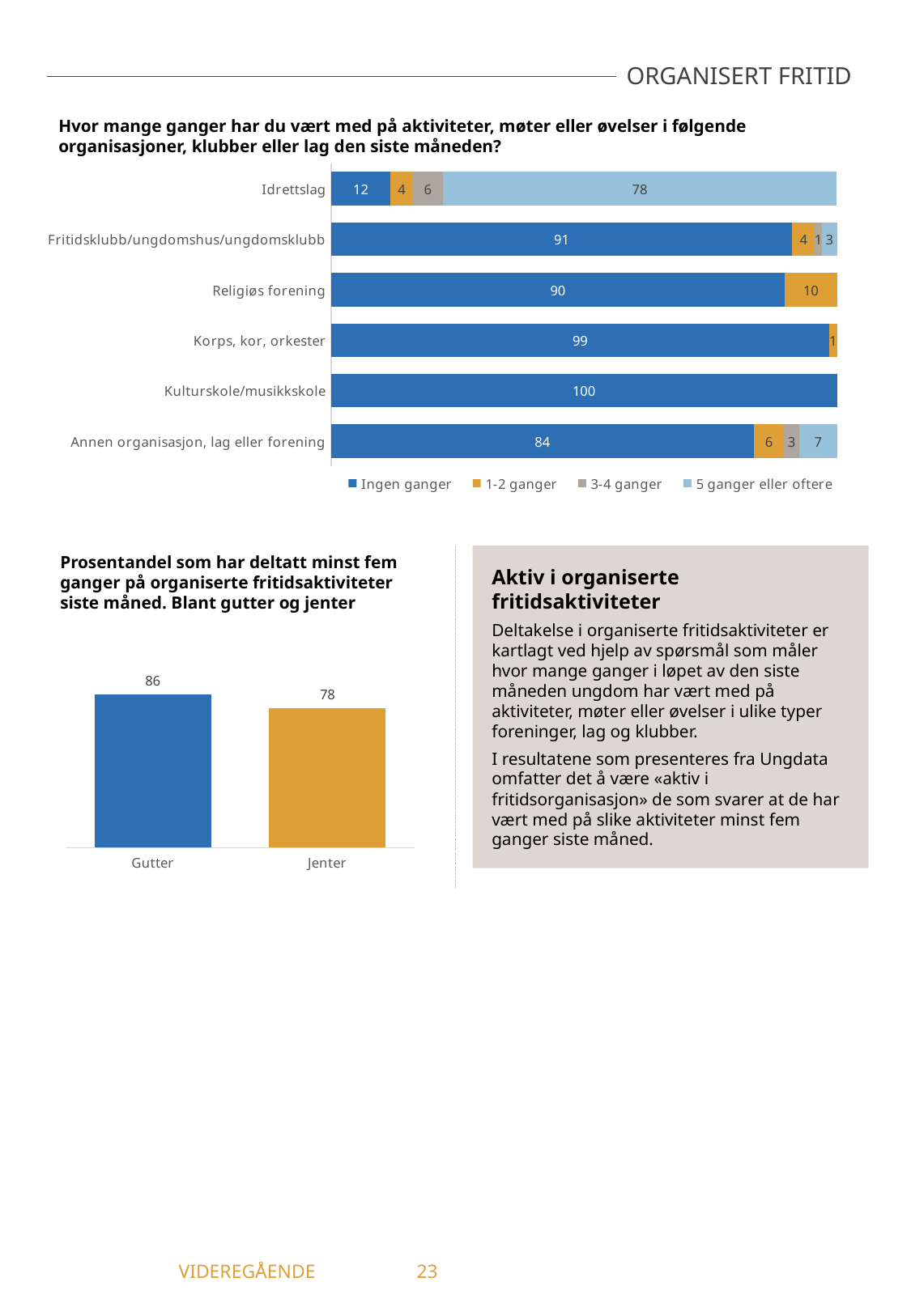
In the top chart, which category has the highest value for 'Ingen ganger'? Kulturskole/musikkskole In the top chart, what is the value for '5 ganger eller oftere' for Idrettslag? 78 What kind of chart is the bottom chart? Bar chart In the bottom chart, what is the value for Gutter? 86 In the top chart, what is the difference between the 'Ingen ganger' values for Korps, kor, orkester and Annen organisasjon, lag eller forening? 15 In the top chart, how many categories are shown? 6 In the top chart, what is the value for '3-4 ganger' for Annen organisasjon, lag eller forening? 3 In the top chart, what is the value for 'Ingen ganger' for Fritidsklubb/ungdomshus/ungdomsklubb? 91 In the bottom chart, what is the difference between the values for Gutter and Jenter? 8 In the top chart, what is the value for '1-2 ganger' for Religiøs forening? 10 In the top chart, how many series does the legend list? 4 In the top chart, which category has the lowest value for 'Ingen ganger'? Idrettslag